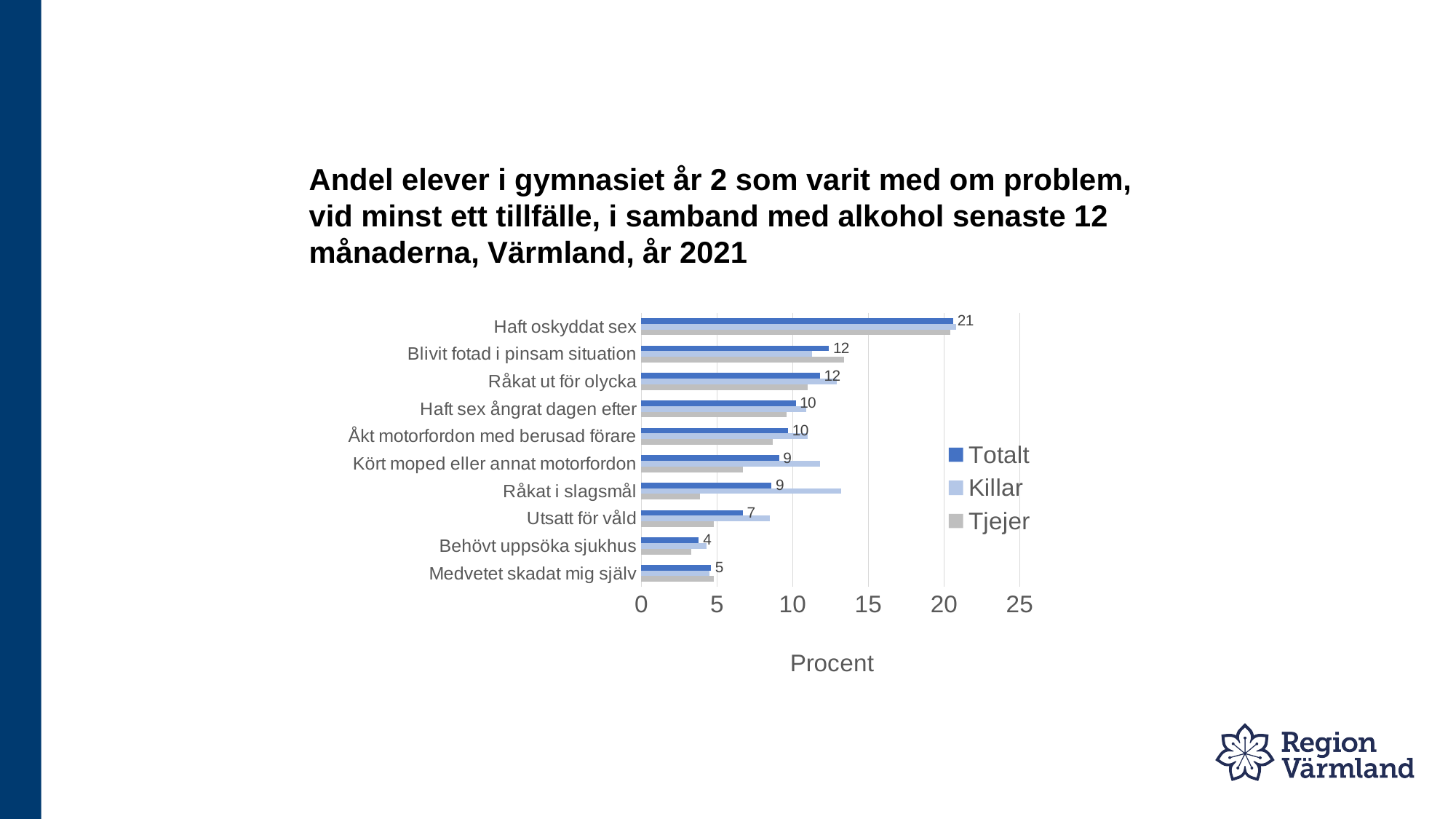
What is the difference between the Totalt values for "Haft oskyddat sex" and "Blivit fotad i pinsam situation"? 9 What is the Totalt value for "Haft oskyddat sex"? 21 For "Råkat i slagsmål", which is larger, the Killar value or the Tjejer value? Killar Which category has the lowest Totalt value? Behövt uppsöka sjukhus Is the Killar value for "Råkat i slagsmål" greater or less than 10? greater Which category has the highest Totalt value? Haft oskyddat sex What is the Totalt value for "Utsatt för våld"? 7 What is the title of the horizontal axis? Procent How many categories are shown on the chart? 10 Is the Tjejer value for "Råkat i slagsmål" greater or less than 5? less What is the Totalt value for "Behövt uppsöka sjukhus"? 4 How many series does the legend list? 3